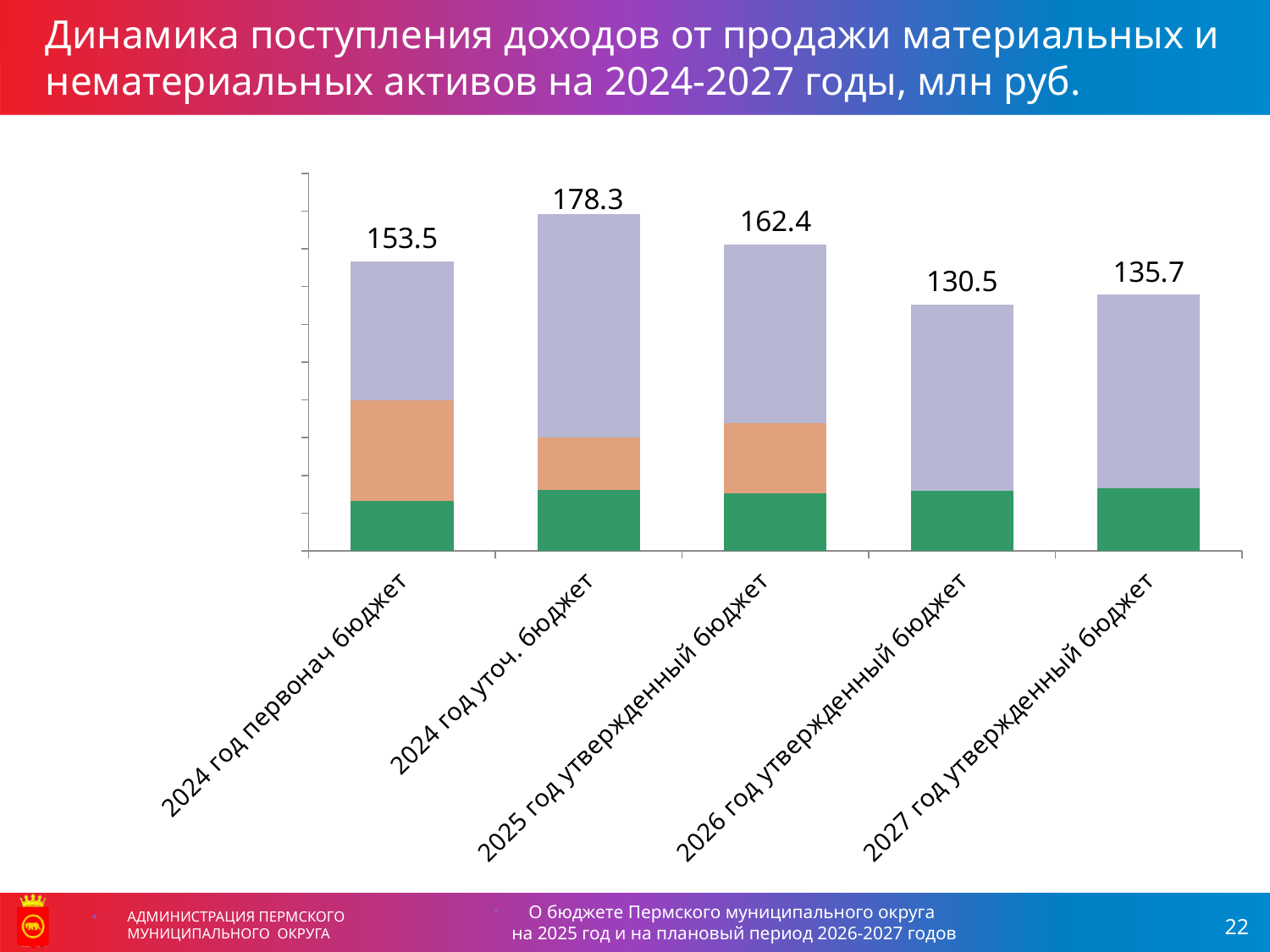
What is the total value shown for the 2024 год первонач бюджет bar? 153.5 Which is larger, the total for 2025 год утвержденный бюджет or for 2024 год первонач бюджет? 2025 год утвержденный бюджет What is the total value shown for the 2025 год утвержденный бюджет bar? 162.4 Which category has the lowest total value? 2026 год утвержденный бюджет How many categories are shown on the x axis? 5 What is the difference between the totals for 2024 год уточ. бюджет and 2024 год первонач бюджет? 24.8 What is the total value shown for the 2024 год уточ. бюджет bar? 178.3 Which category has the highest total value? 2024 год уточ. бюджет What is the total value shown for the 2027 год утвержденный бюджет bar? 135.7 Do the totals rise or fall from 2025 год утвержденный бюджет to 2026 год утвержденный бюджет? Fall What kind of chart is shown on the slide? Stacked bar chart What is the difference between the totals for 2027 год утвержденный бюджет and 2026 год утвержденный бюджет? 5.2